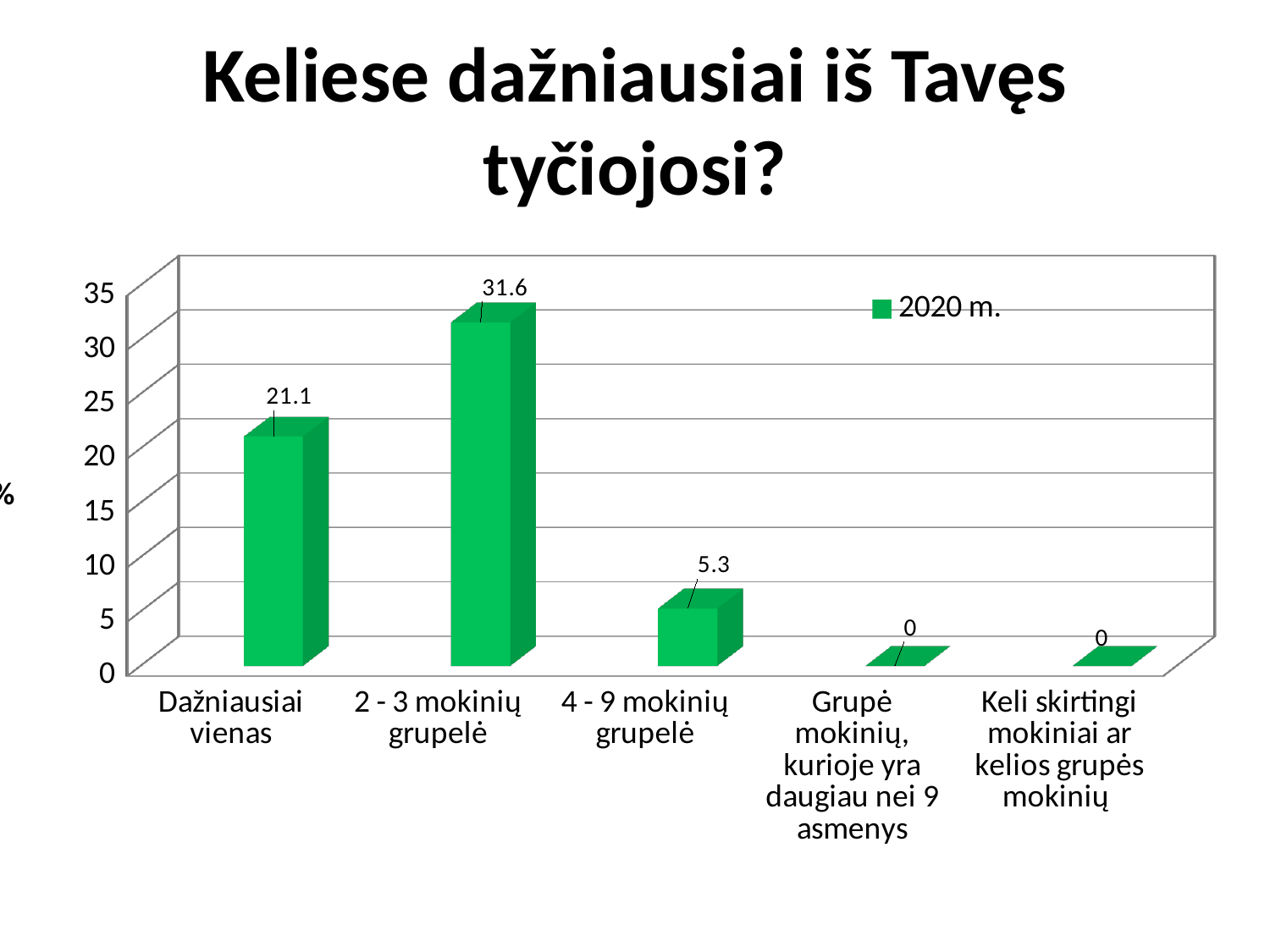
What is the value for "4 - 9 mokinių grupelė"? 5.3 What series name is shown in the legend? 2020 m. What is the difference between the values for "Dažniausiai vienas" and "4 - 9 mokinių grupelė"? 15.8 What is the value for "2 - 3 mokinių grupelė"? 31.6 What is the difference between the values for "2 - 3 mokinių grupelė" and "Dažniausiai vienas"? 10.5 What is the value for "Keli skirtingi mokiniai ar kelios grupės mokinių"? 0 What is the value for "Dažniausiai vienas"? 21.1 How many series does the legend list? 1 What kind of chart is shown on the slide? bar chart Which category has the highest value? 2 - 3 mokinių grupelė How many categories are shown on the x axis? 5 Which is larger, the value for "Dažniausiai vienas" or the value for "4 - 9 mokinių grupelė"? Dažniausiai vienas